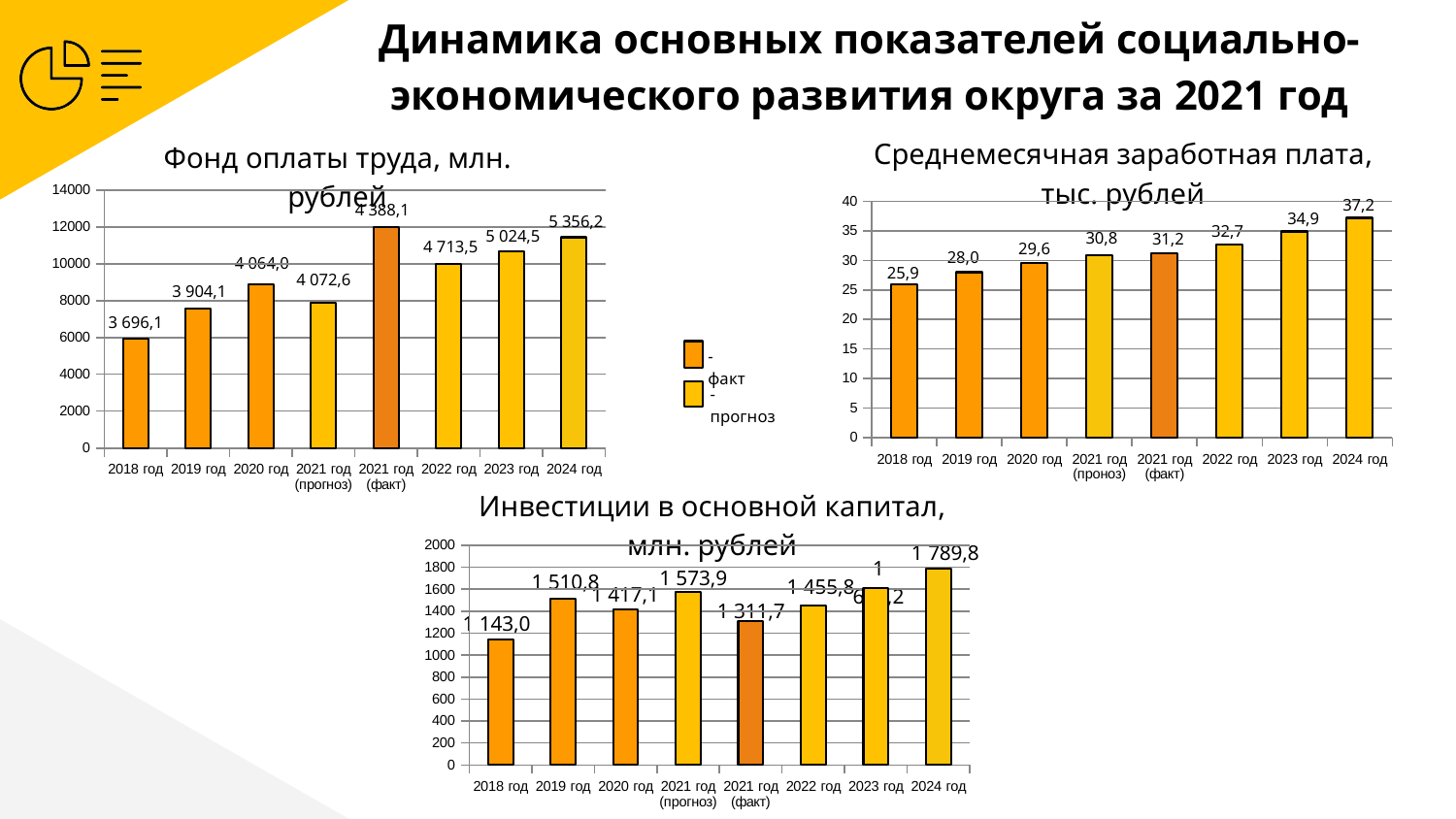
In the chart 'Фонд оплаты труда, млн. рублей', what is the value for 2021 год (факт)? 4 388,1 How many bars are shown in the chart 'Инвестиции в основной капитал, млн. рублей'? 8 In the chart 'Инвестиции в основной капитал, млн. рублей', is the value for 2021 год (факт) greater or less than 1400? less How many entries does the legend in the middle of the slide list? 2 In the chart 'Среднемесячная заработная плата, тыс. рублей', what is the value for 2020 год? 29,6 In the chart 'Инвестиции в основной капитал, млн. рублей', what is the value for 2024 год? 1 789,8 In the chart 'Инвестиции в основной капитал, млн. рублей', which year has the lowest value? 2018 год In the chart 'Среднемесячная заработная плата, тыс. рублей', what is the difference between the values for 2024 год and 2018 год? 11,3 In the chart 'Среднемесячная заработная плата, тыс. рублей', do the values rise or fall from 2018 год to 2024 год? rise In the chart 'Фонд оплаты труда, млн. рублей', what is the value for 2018 год? 3 696,1 In the chart 'Среднемесячная заработная плата, тыс. рублей', which is larger: 2021 год (факт) or 2021 год (проноз)? 2021 год (факт)